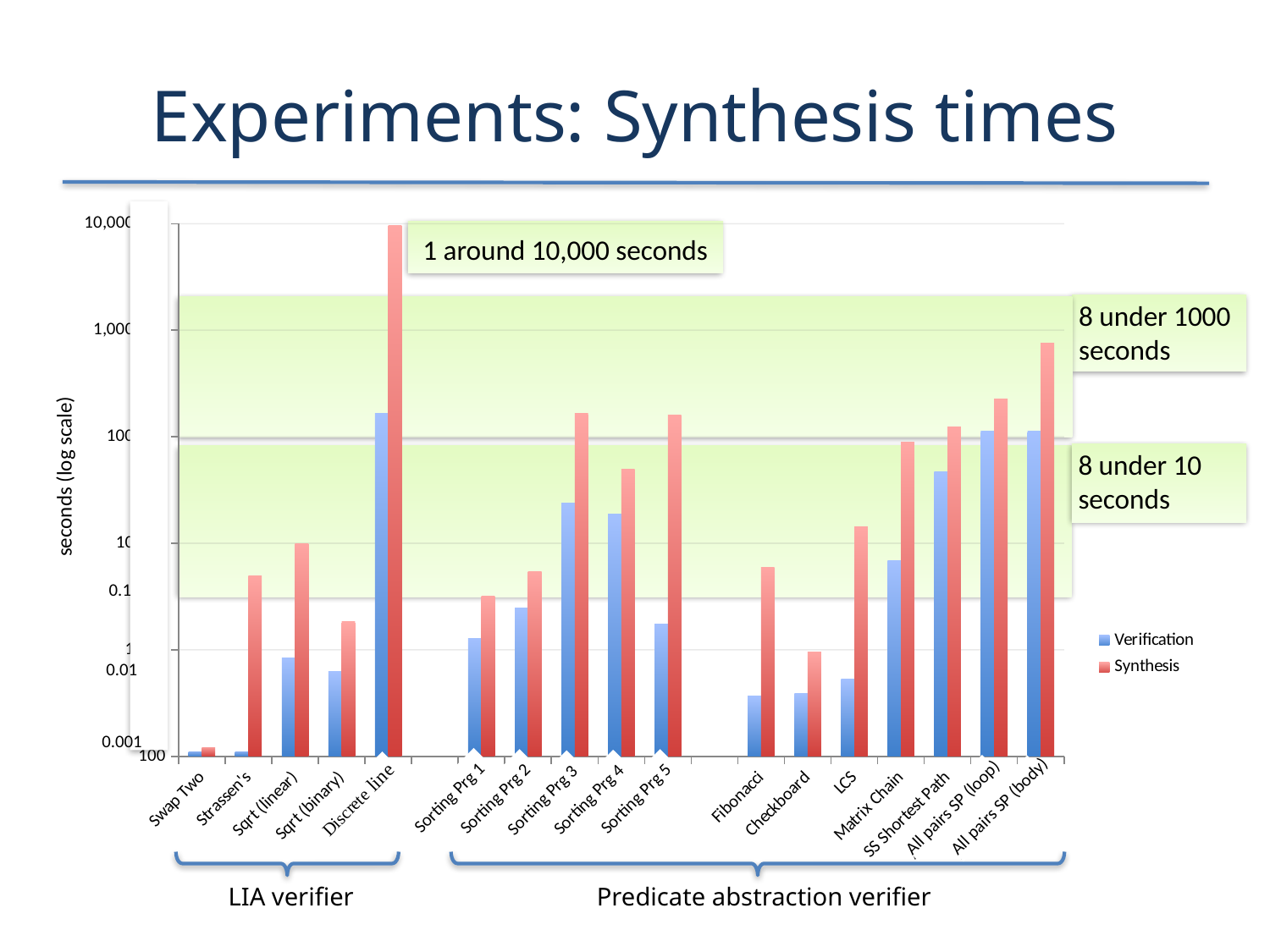
Which series is shown in red in the legend? Synthesis Which category has the highest Verification time? Discrete line Which has the larger Synthesis time: Fibonacci or LCS? LCS Which category has the highest Synthesis time? Discrete line For Sorting Prg 3, which is larger: the Verification time or the Synthesis time? Synthesis How many series does the legend list? 2 Which category has the lowest Synthesis time? Swap Two What is the title of the slide? Experiments: Synthesis times What kind of chart is shown on the slide? bar chart Which has the larger Synthesis time: All pairs SP (body) or Matrix Chain? All pairs SP (body) How many program categories are shown along the x axis? 17